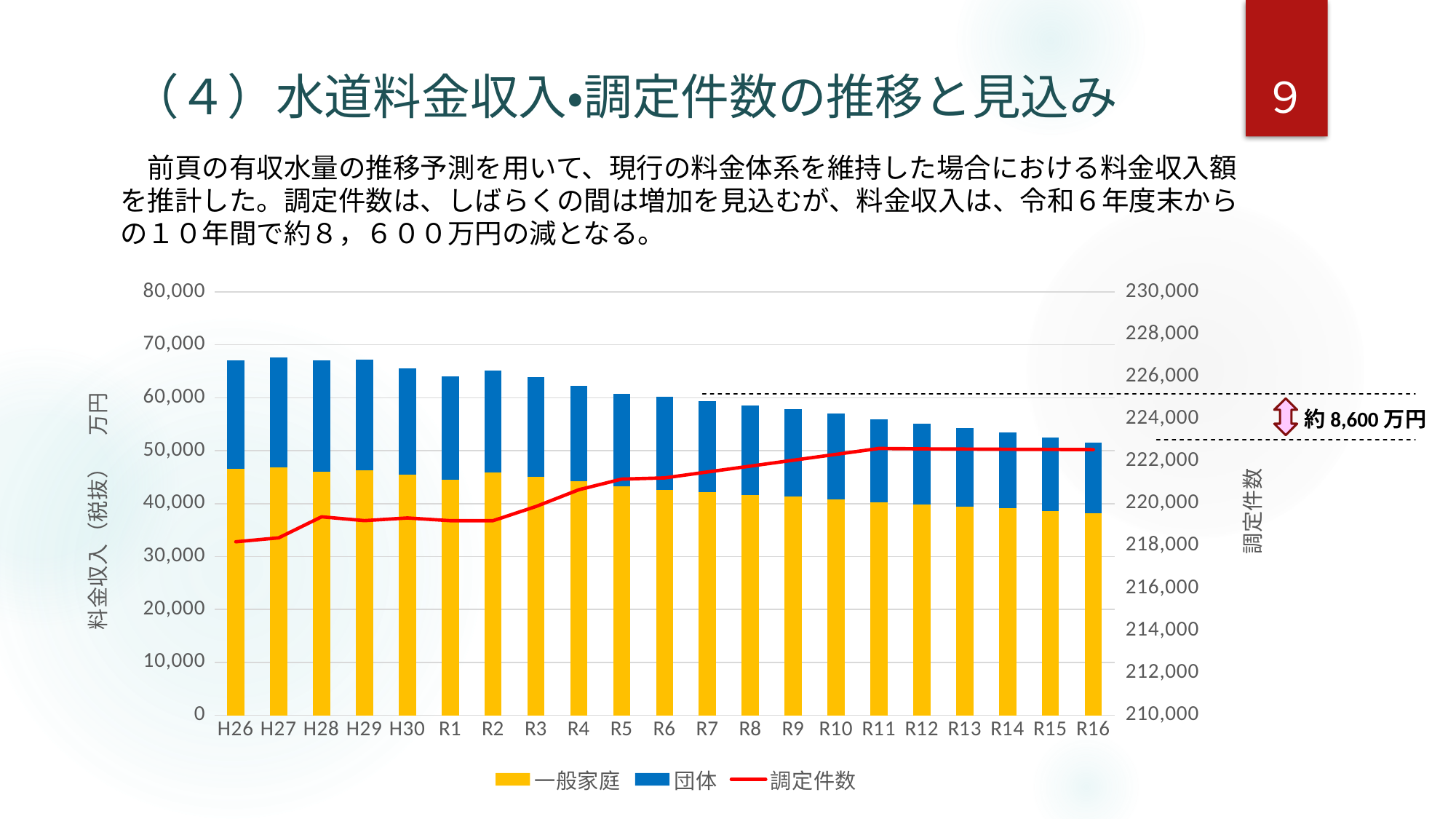
Which year has the lowest value on the 調定件数 line? H26 How many fiscal-year categories are shown on the x axis? 21 What amount does the annotation on the right side of the chart indicate? 約 8,600 万円 Is the total stacked bar for H26 greater or less than 60,000? greater Which year has the lowest total stacked bar (料金収入)? R16 Is the total stacked bar for R16 greater or less than 60,000? less Is the 一般家庭 value for R16 greater or less than 40,000? less Does the total 料金収入 (stacked bars) generally rise or fall from H26 to R16? fall How many series does the legend list? 3 Which series are listed in the legend? 一般家庭, 団体, 調定件数 What kind of chart is shown on the slide? A combined stacked bar and line chart